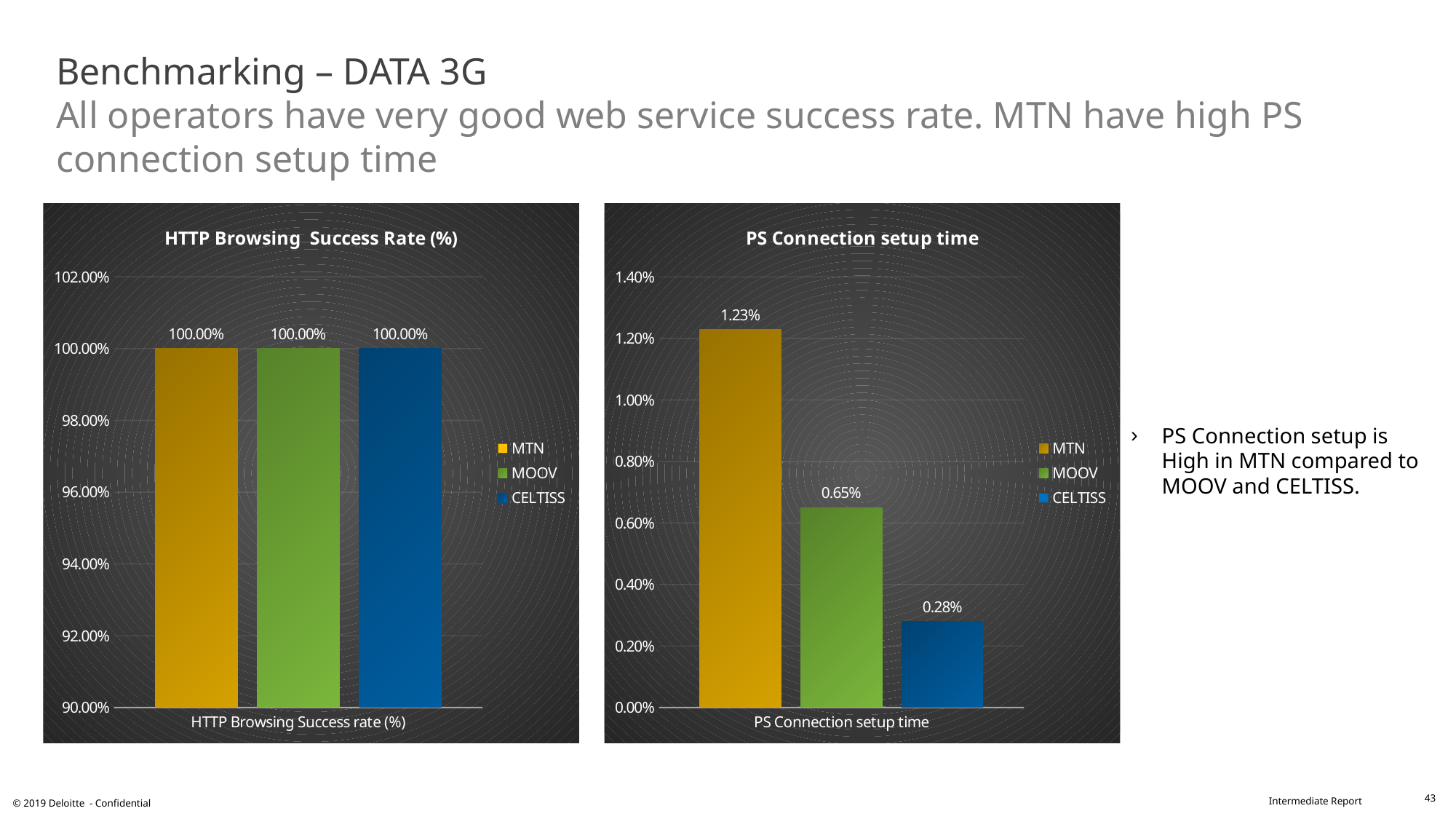
What kind of chart is the 'PS Connection setup time' chart? Bar chart In the 'PS Connection setup time' chart, what is the value for CELTISS? 0.28% In the 'HTTP Browsing Success Rate (%)' chart, what is the value for MTN? 100.00% In the 'PS Connection setup time' chart, which is larger, the value for MOOV or the value for CELTISS? MOOV In the 'HTTP Browsing Success Rate (%)' chart, what is the value for CELTISS? 100.00% How many series does the legend of the 'HTTP Browsing Success Rate (%)' chart list? 3 In the 'PS Connection setup time' chart, which operator has the highest value? MTN In the 'PS Connection setup time' chart, what is the value for MOOV? 0.65% In the 'PS Connection setup time' chart, what is the difference between the MTN and MOOV values? 0.58% In the 'PS Connection setup time' chart, which operator has the lowest value? CELTISS In the 'PS Connection setup time' chart, what is the value for MTN? 1.23% In the 'PS Connection setup time' chart, is the value for MTN greater or less than 1.00%? greater